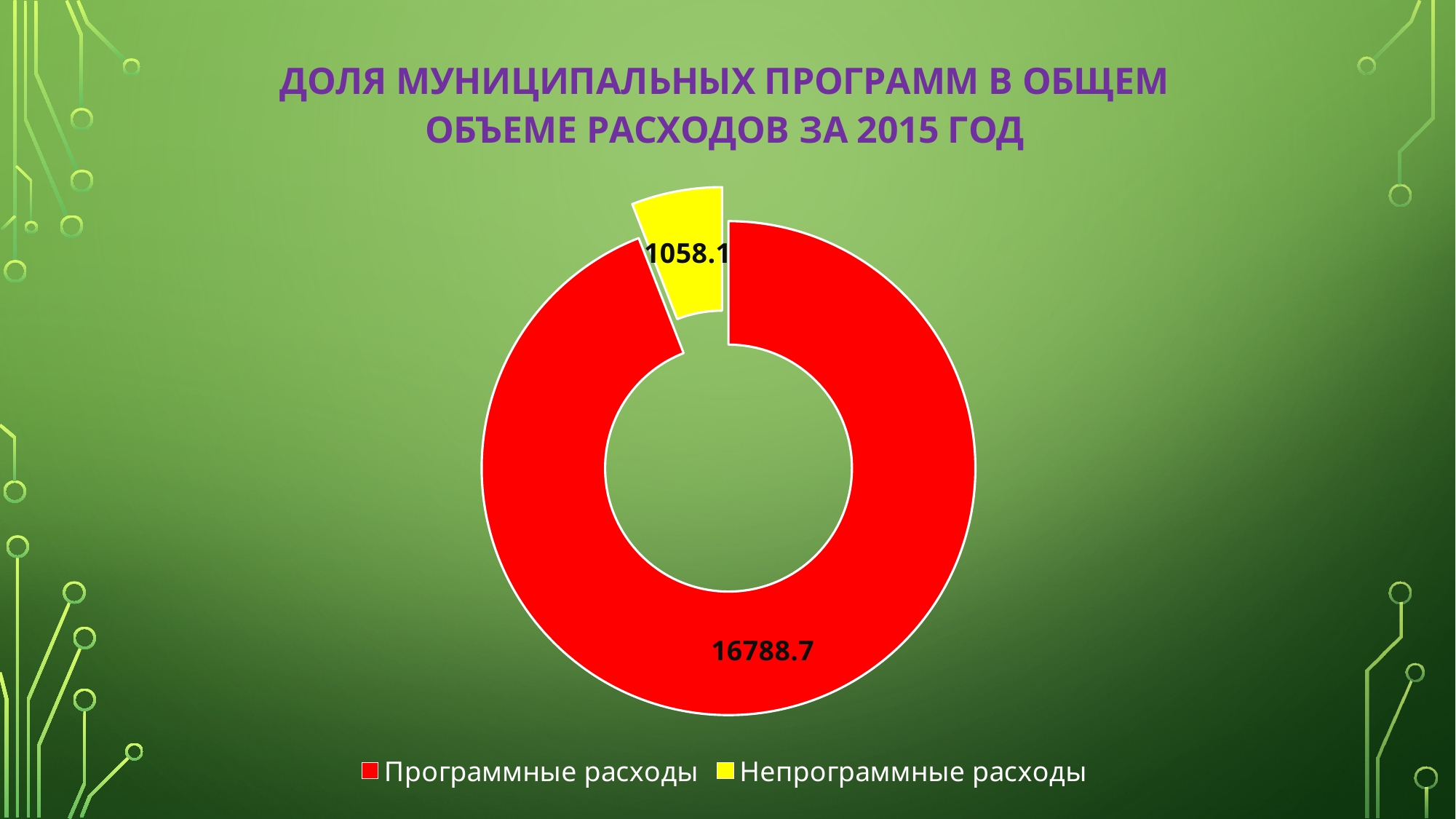
How many categories are shown in the chart? 2 What type of chart is shown on the slide? Doughnut (pie) chart How many entries does the legend list? 2 Which category has the largest value in the chart? Программные расходы What value is shown for Непрограммные расходы? 1058.1 What value is shown for Программные расходы? 16788.7 Which category has the smallest value in the chart? Непрограммные расходы What is the total of the two values shown in the chart? 17846.8 What is the difference between Программные расходы and Непрограммные расходы? 15730.6 Which is larger: Программные расходы or Непрограммные расходы? Программные расходы What is the title of the chart? Доля муниципальных программ в общем объеме расходов за 2015 год What colour represents Непрограммные расходы in the chart? Yellow